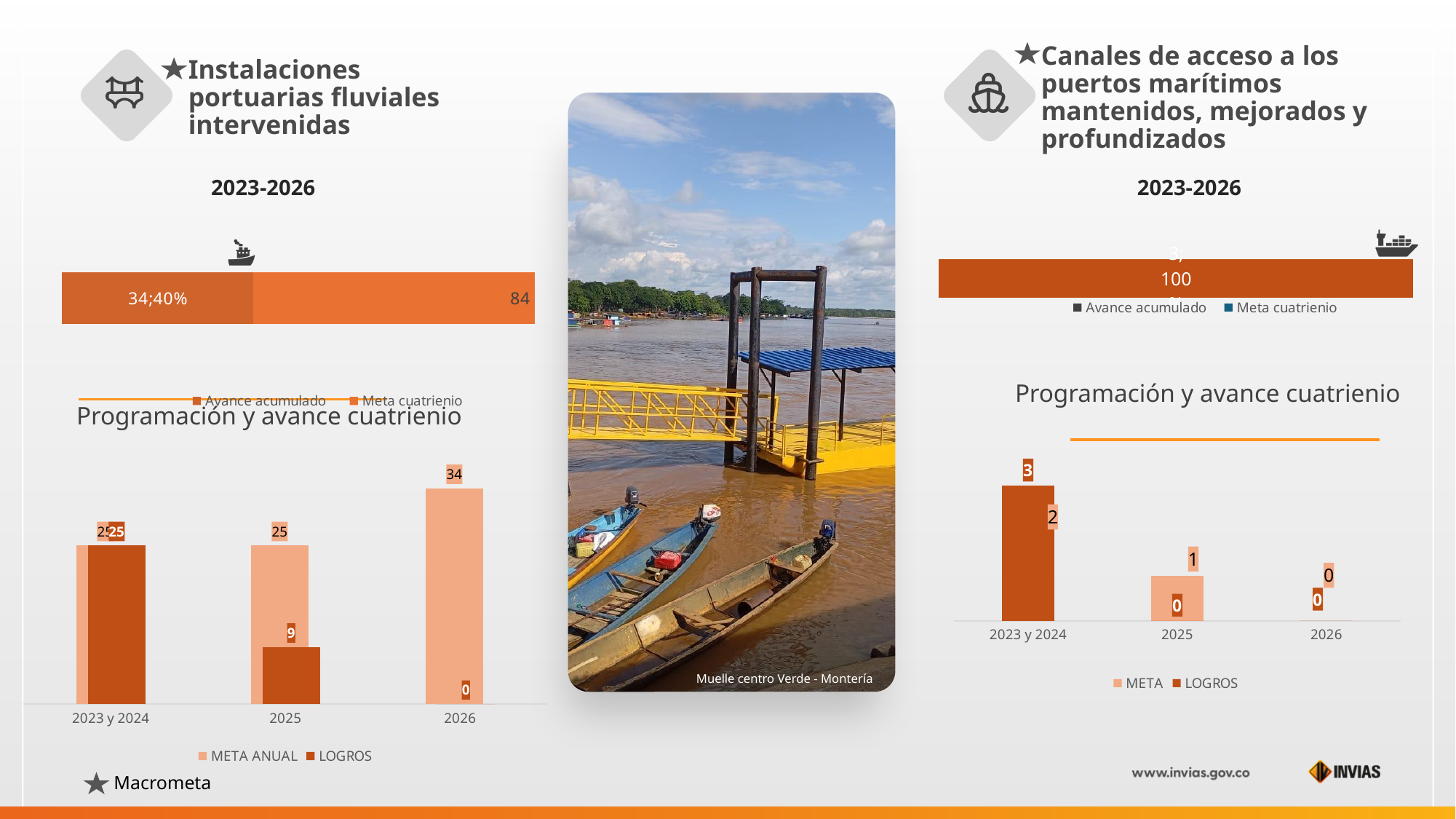
In the top-left horizontal bar chart under 'Instalaciones portuarias fluviales intervenidas', what label is shown for Avance acumulado? 34;40% In the bottom-left chart 'Programación y avance cuatrienio' (Instalaciones portuarias fluviales), what kind of chart is it? Bar chart In the bottom-left chart 'Programación y avance cuatrienio' (Instalaciones portuarias fluviales), what is the META ANUAL value for 2026? 34 In the bottom-left chart 'Programación y avance cuatrienio' (Instalaciones portuarias fluviales), what is the LOGROS value for 2025? 9 In the bottom-right chart 'Programación y avance cuatrienio' (Canales de acceso a los puertos marítimos), which is larger for 2023 y 2024: META or LOGROS? LOGROS In the bottom-right chart 'Programación y avance cuatrienio' (Canales de acceso a los puertos marítimos), what is the LOGROS value for 2023 y 2024? 3 In the top-left horizontal bar chart under 'Instalaciones portuarias fluviales intervenidas', what is the Meta cuatrienio value? 84 In the bottom-left chart 'Programación y avance cuatrienio' (Instalaciones portuarias fluviales), what is the difference between META ANUAL and LOGROS for 2025? 16 In the bottom-right chart 'Programación y avance cuatrienio' (Canales de acceso a los puertos marítimos), how many categories are shown on the x axis? 3 In the bottom-right chart 'Programación y avance cuatrienio' (Canales de acceso a los puertos marítimos), what is the META value for 2025? 1 In the bottom-left chart 'Programación y avance cuatrienio' (Instalaciones portuarias fluviales), how many series does the legend list? 2 In the bottom-left chart 'Programación y avance cuatrienio' (Instalaciones portuarias fluviales), which year has the highest META ANUAL value? 2026